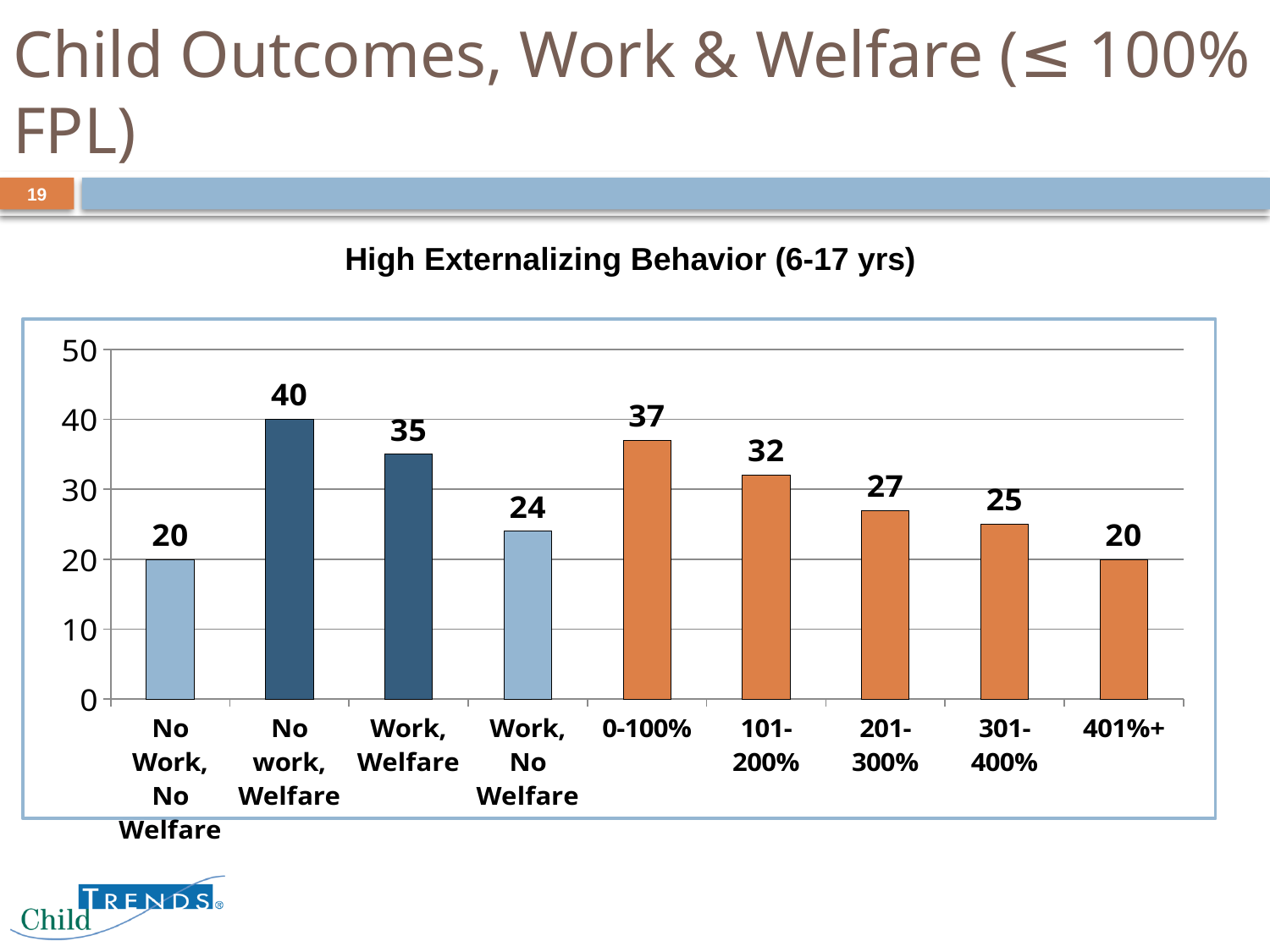
What is the value for the 'No work, Welfare' category? 40 Which category has the highest value? No work, Welfare Do the values rise or fall across the income categories from '0-100%' to '401%+'? Fall What is the title of the chart? High Externalizing Behavior (6-17 yrs) Which is larger, the value for 'Work, Welfare' or the value for '101-200%'? Work, Welfare What kind of chart is shown on the slide? Bar chart What is the difference between the values for 'No work, Welfare' and 'No Work, No Welfare'? 20 How many bars are shown in the chart? 9 What is the difference between the values for '0-100%' and '401%+'? 17 What is the value for the '0-100%' category? 37 What is the value for the 'Work, No Welfare' category? 24 What is the value for the '201-300%' category? 27